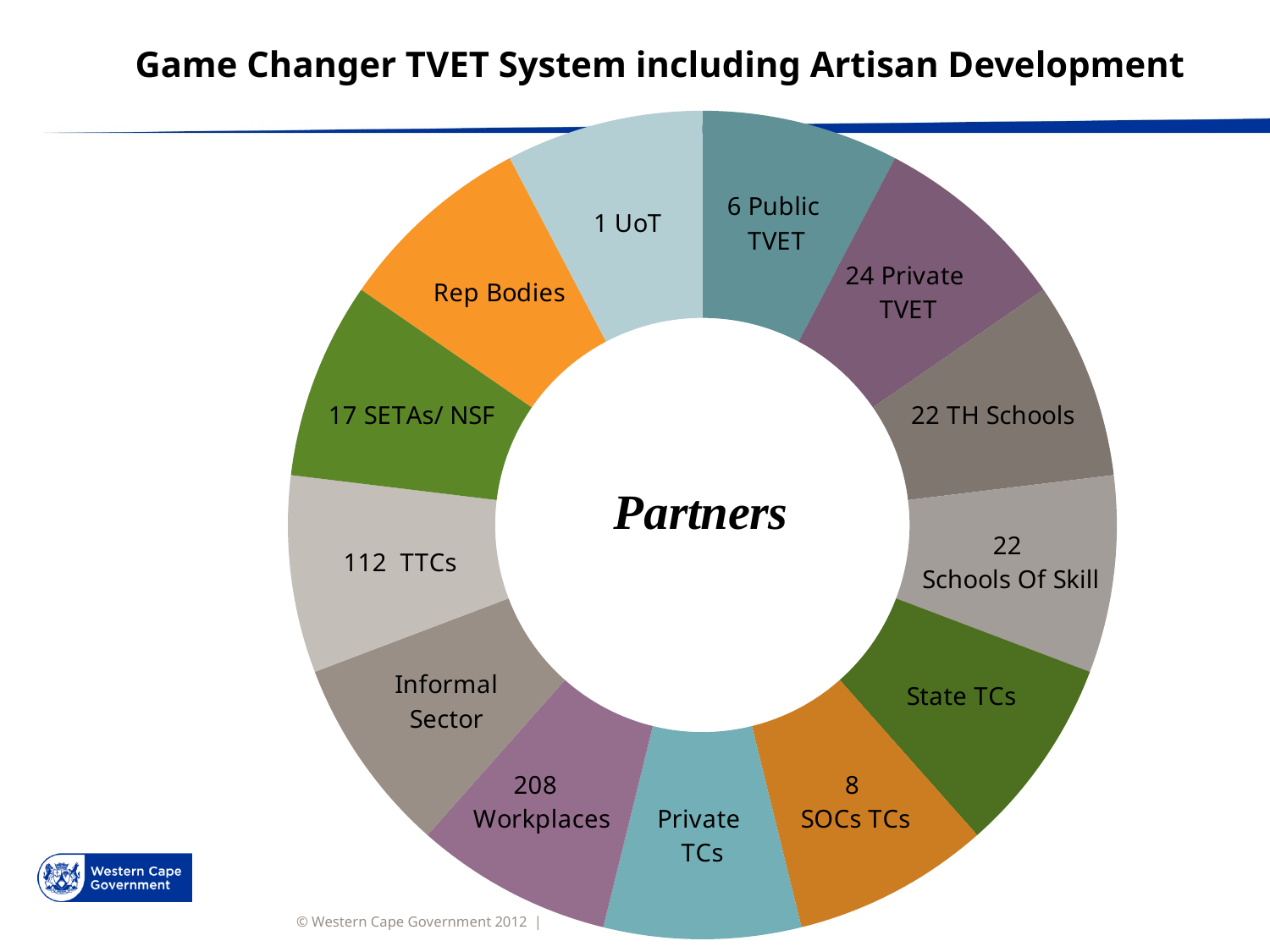
How many SETAs/NSF are shown in the chart label? 17 What is the difference between the number of Private TVET and Public TVET partners shown in the labels? 18 What word is printed in the centre of the doughnut chart? Partners How many segments does the doughnut chart have? 13 How many TTCs are shown in the chart label? 112 Which label shows a larger number, Workplaces or TTCs? Workplaces How many Workplaces are shown in the chart label? 208 How many Public TVET partners are shown in the chart label? 6 What kind of chart is shown on the slide? Doughnut (pie) chart How many SOCs TCs are shown in the chart label? 8 What is the title of the slide containing the chart? Game Changer TVET System including Artisan Development How many Private TVET partners are shown in the chart label? 24